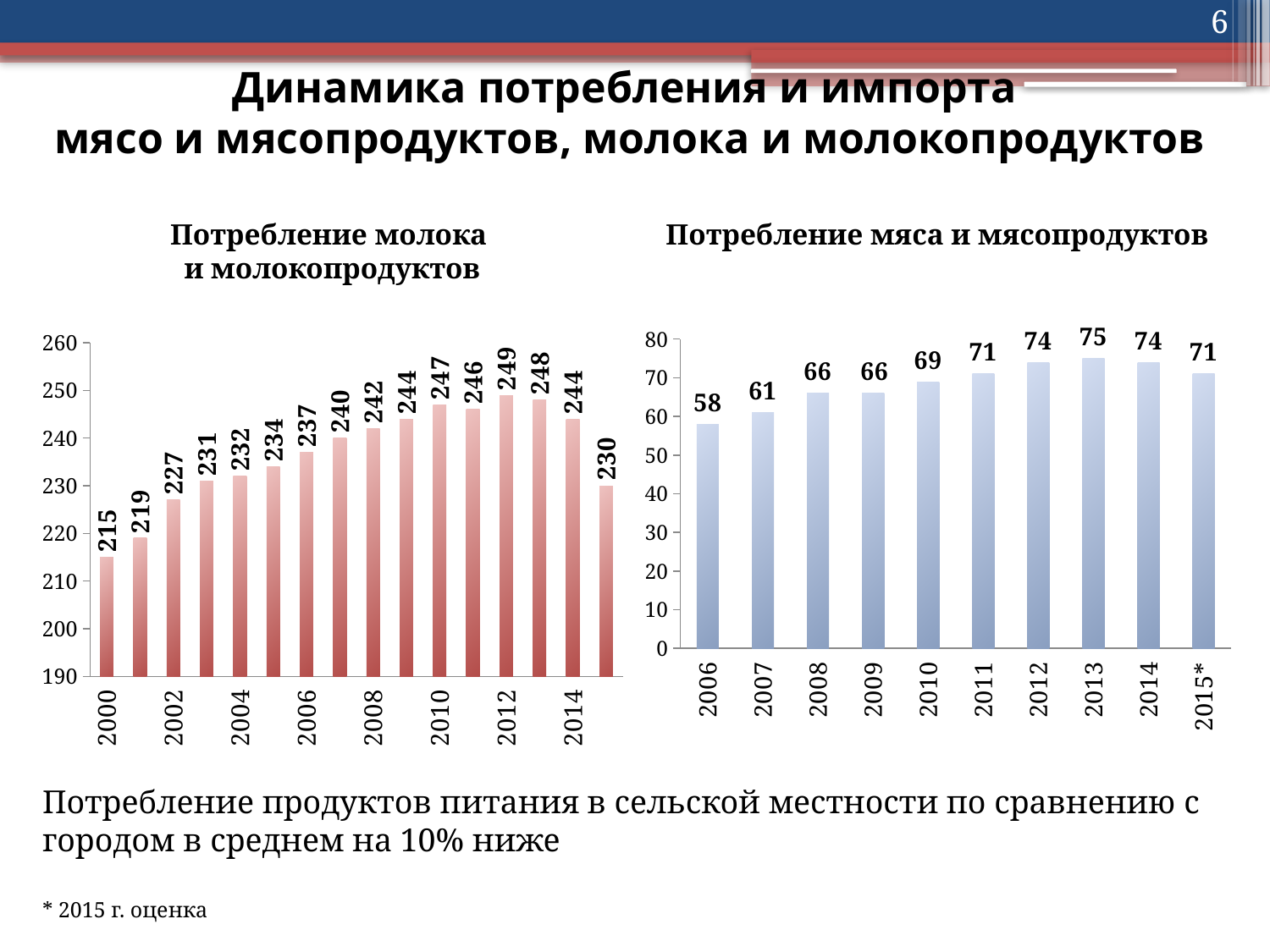
In the chart 'Потребление молока и молокопродуктов', how many bars are plotted? 16 In the chart 'Потребление мяса и мясопродуктов', which year has the lowest value? 2006 What type of chart is 'Потребление молока и молокопродуктов'? Bar chart In the chart 'Потребление мяса и мясопродуктов', is the value for 2012 larger than the value for 2015*? Yes, 2012 In the chart 'Потребление мяса и мясопродуктов', what is the difference between the values for 2013 and 2006? 17 In the chart 'Потребление молока и молокопродуктов', what is the value for 2012? 249 In the chart 'Потребление мяса и мясопродуктов', what is the value for 2010? 69 In the chart 'Потребление мяса и мясопродуктов', which year has the highest value? 2013 In the chart 'Потребление молока и молокопродуктов', what is the value for 2000? 215 In the chart 'Потребление молока и молокопродуктов', which year has the highest value? 2012 In the chart 'Потребление молока и молокопродуктов', what is the difference between the values for 2010 and 2000? 32 In the chart 'Потребление мяса и мясопродуктов', how many years are shown on the x axis? 10